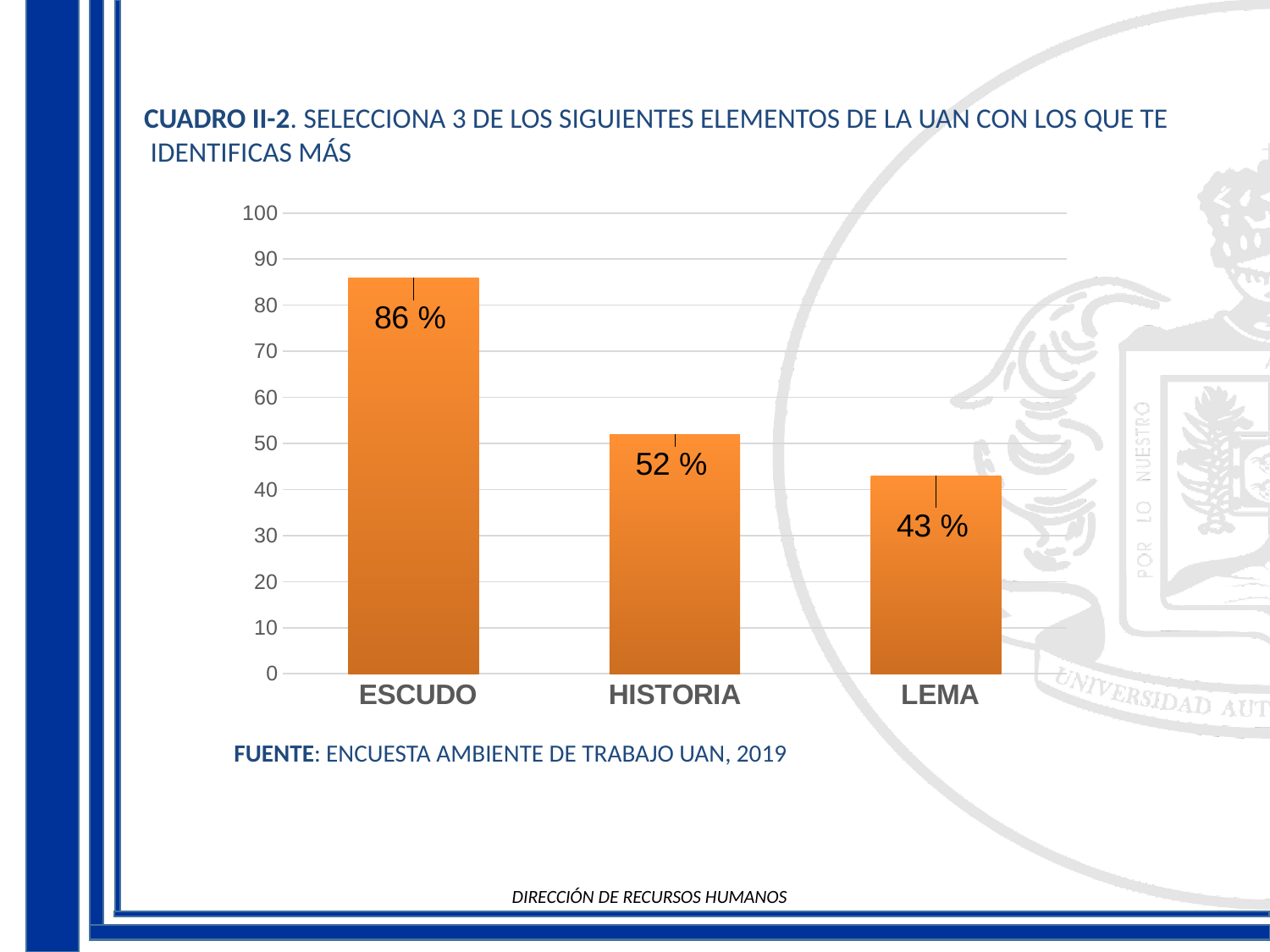
How many categories are shown on the x axis? 3 Is the value for ESCUDO greater or less than 80? greater What is the value for ESCUDO? 86 % Do the values rise or fall from ESCUDO to LEMA along the x axis? fall What is the difference between the values for HISTORIA and LEMA? 9 % Which is larger, the value for HISTORIA or the value for LEMA? HISTORIA What is the value for LEMA? 43 % What is the difference between the values for ESCUDO and HISTORIA? 34 % Which category has the highest value? ESCUDO Which category has the lowest value? LEMA What is the value for HISTORIA? 52 % What kind of chart is shown on the slide? bar chart